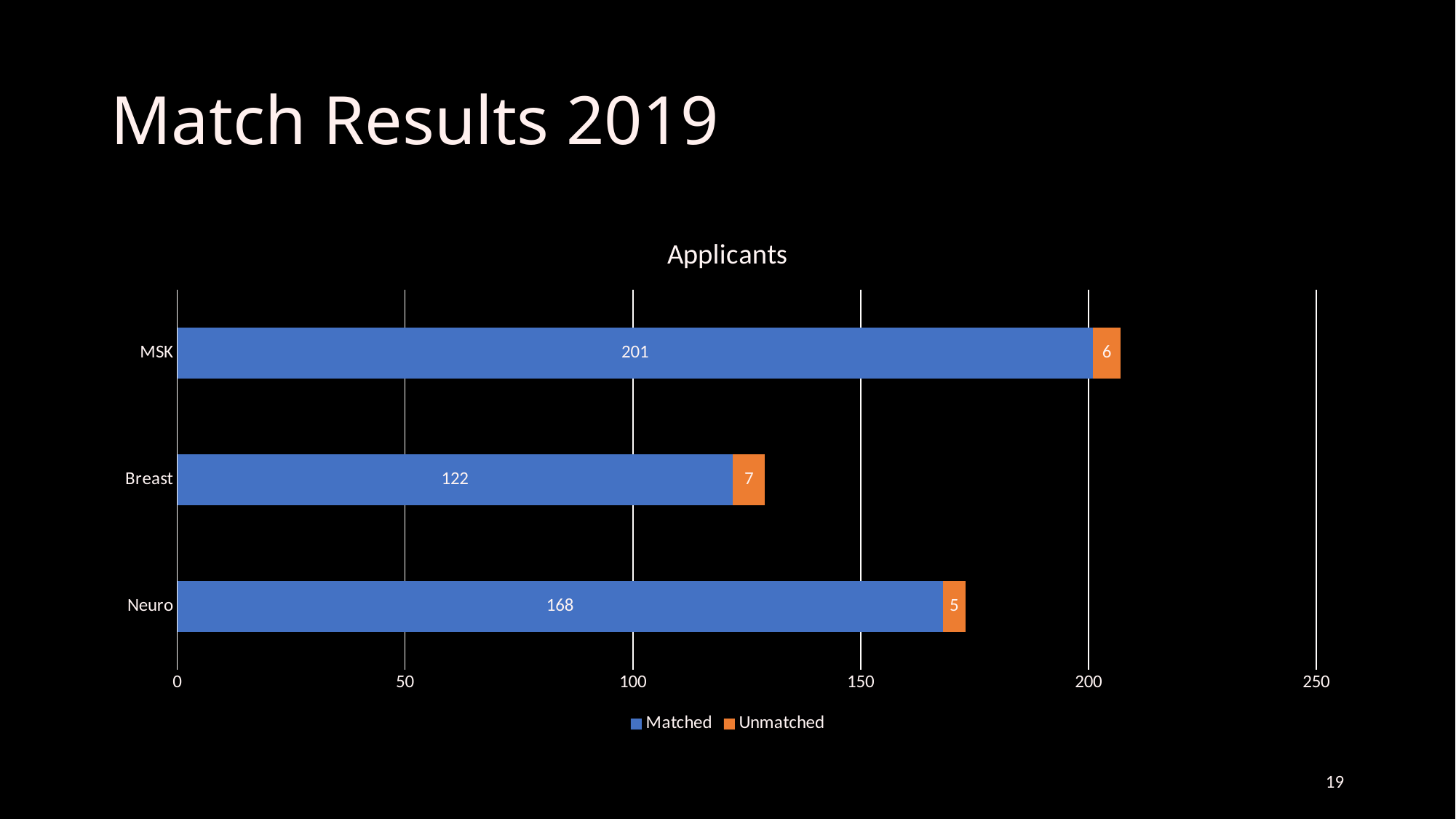
What is the difference between the Matched values for MSK and Neuro? 33 What is the Matched value for MSK? 201 Which is larger, the Unmatched value for Breast or the Unmatched value for Neuro? Breast Which category has the lowest Matched value? Breast What is the Unmatched value for Breast? 7 What kind of chart is shown on the slide? Stacked bar chart What is the total of the stacked bar for MSK? 207 What is the total of the stacked bar for Breast? 129 What is the Matched value for Neuro? 168 How many series does the legend list? 2 Which category has the highest Matched value? MSK How many categories are shown on the chart? 3